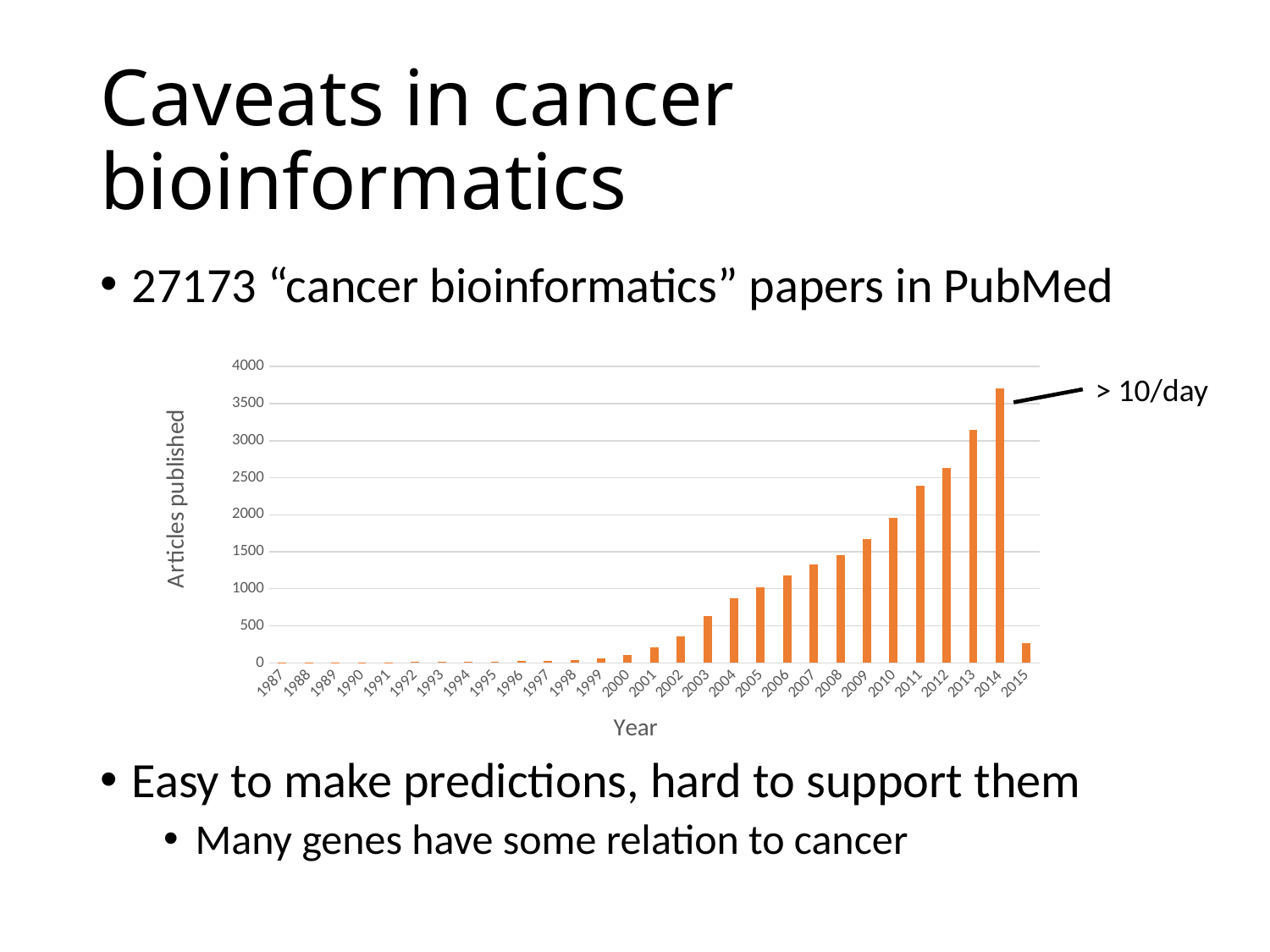
Is the value for 2014 greater or less than 3500? greater Which year has more articles published, 2002 or 2003? 2003 What is the label of the vertical axis of the chart? Articles published Which year has more articles published, 2014 or 2015? 2014 How many years are shown on the x axis of the chart? 29 What kind of chart is shown on the slide? bar chart Is the value for 2013 greater or less than 3000? greater Is the value for 2004 greater or less than 1000? less Do the values rise or fall from 2000 to 2014? rise Which year has the highest number of articles published? 2014